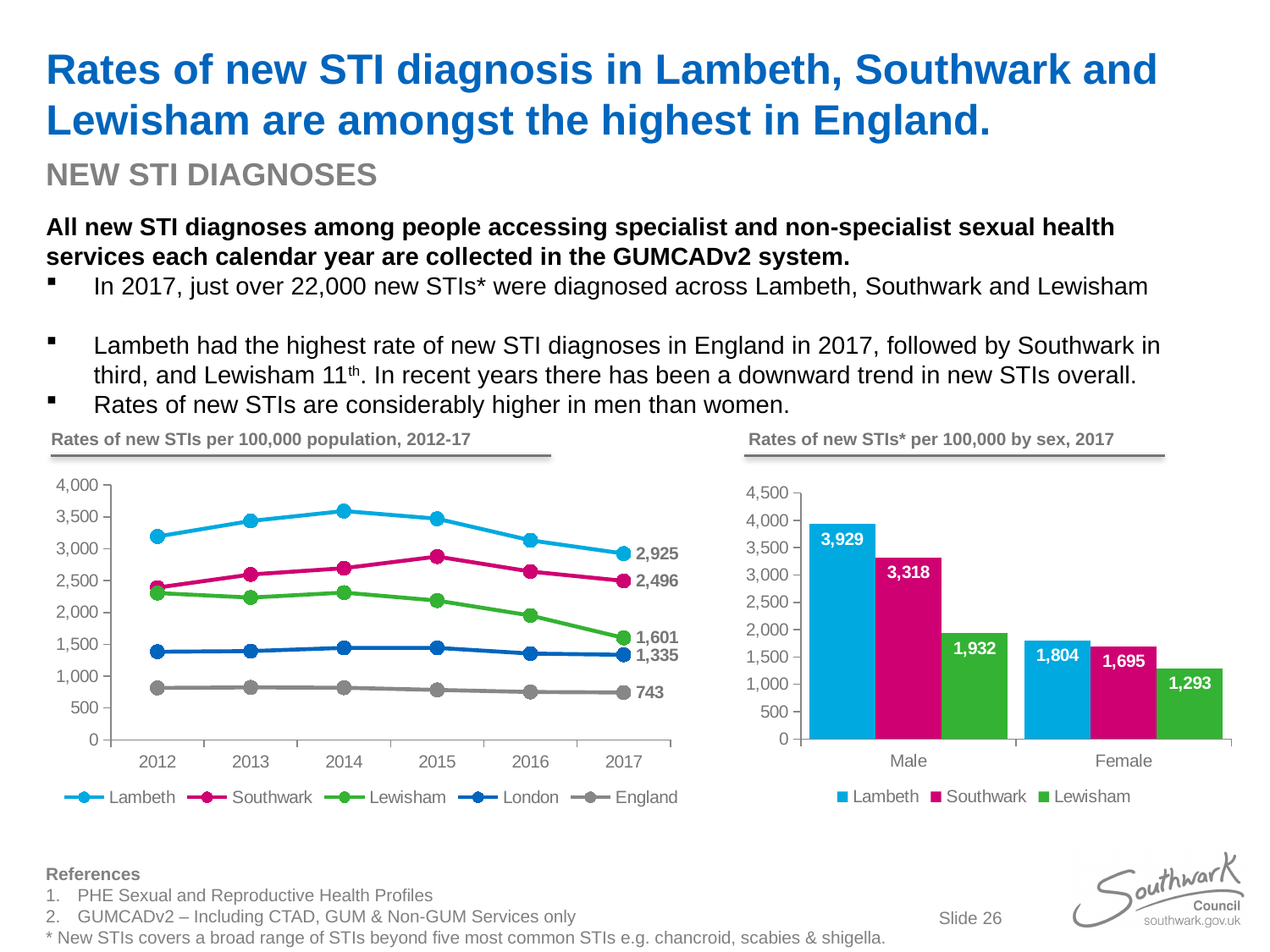
In the chart 'Rates of new STIs* per 100,000 by sex, 2017', what is the value for Southwark males? 3,318 In the chart 'Rates of new STIs per 100,000 population, 2012-17', does the Lewisham line rise or fall between 2014 and 2017? fall What kind of chart is 'Rates of new STIs per 100,000 population, 2012-17'? line chart In the chart 'Rates of new STIs* per 100,000 by sex, 2017', which bar is the lowest? Lewisham Female In the chart 'Rates of new STIs per 100,000 population, 2012-17', what is the value for England in 2017? 743 In the chart 'Rates of new STIs per 100,000 population, 2012-17', how many series does the legend list? 5 In the chart 'Rates of new STIs per 100,000 population, 2012-17', is the value for Lambeth in 2014 greater or less than 3,500? greater In the chart 'Rates of new STIs per 100,000 population, 2012-17', what is the difference between the 2017 values for Southwark and Lewisham? 895 In the chart 'Rates of new STIs per 100,000 population, 2012-17', what is the value for Lambeth in 2017? 2,925 In the chart 'Rates of new STIs* per 100,000 by sex, 2017', which is larger: Lewisham Male or Lambeth Female? Lewisham Male In the chart 'Rates of new STIs* per 100,000 by sex, 2017', what is the difference between the Lambeth male and Lambeth female values? 2,125 What kind of chart is 'Rates of new STIs* per 100,000 by sex, 2017'? bar chart